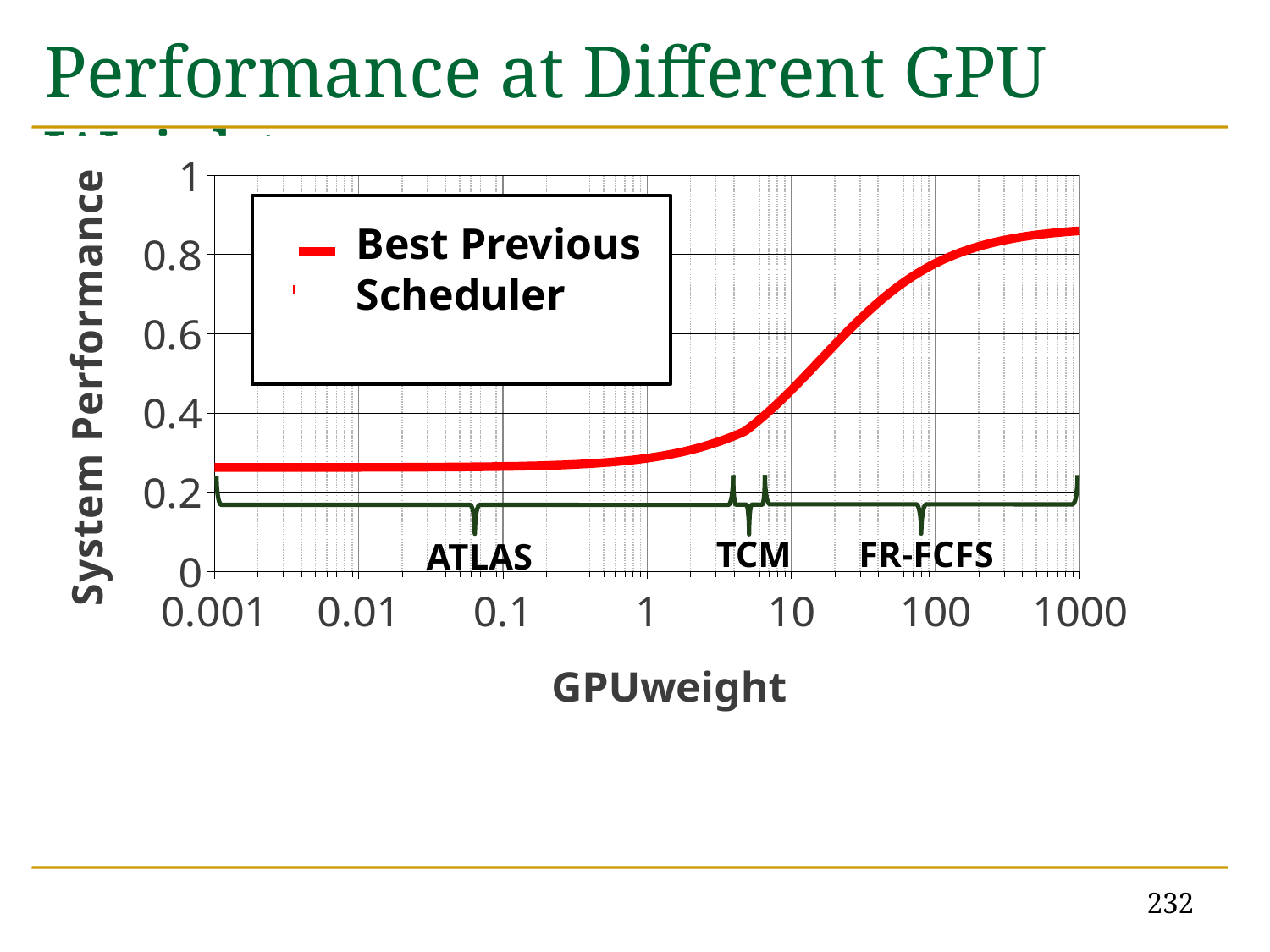
Is the System Performance of the Best Previous Scheduler at GPUweight 0.01 greater or less than 0.2? greater Which is larger, the System Performance of the Best Previous Scheduler at GPUweight 10 or at GPUweight 0.1? at GPUweight 10 Is the System Performance of the Best Previous Scheduler at GPUweight 0.001 greater or less than 0.4? less Does the System Performance of the Best Previous Scheduler rise or fall as GPUweight increases from 0.001 to 1000? rise Is the System Performance of the Best Previous Scheduler at GPUweight 1 greater or less than 0.4? less What kind of chart is shown on the slide? line chart What is the label of the x axis? GPUweight What is the label of the y axis? System Performance What is the highest value shown on the y axis? 1 Which series is shown by the red line in the legend? Best Previous Scheduler